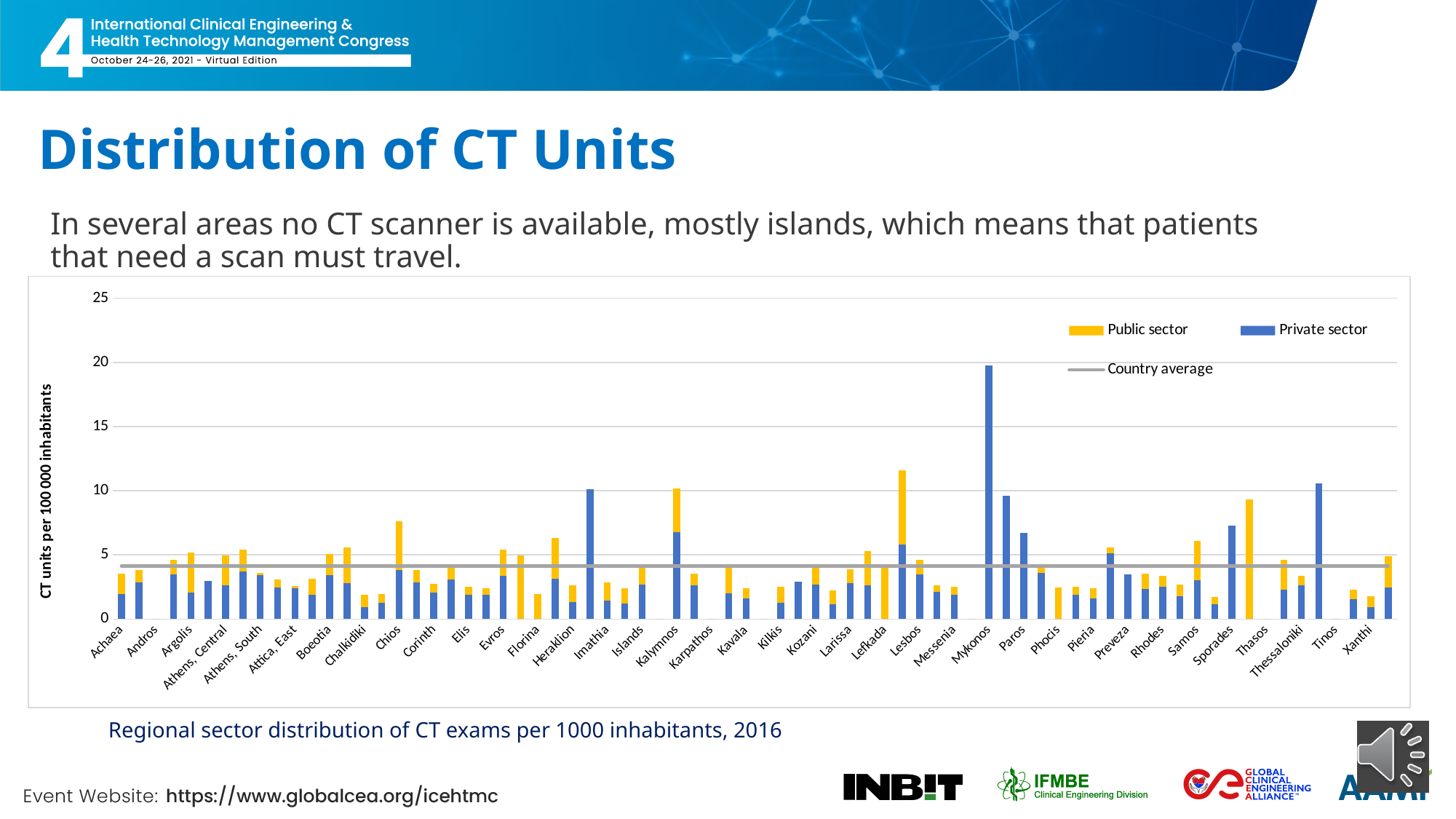
Is the value for Thasos greater or less than 5? less What colour represents the Public sector in the chart? Yellow How many entries does the chart legend list? 3 Is the country average line greater or less than 5? less What kind of chart is shown on the slide? Stacked bar chart What is the label of the vertical axis? CT units per 100 000 inhabitants Is the value for Thasos greater or less than 10? less Which is larger, the value for Mykonos or the value for Paros? Mykonos Which region has the highest total CT units per 100 000 inhabitants? Mykonos